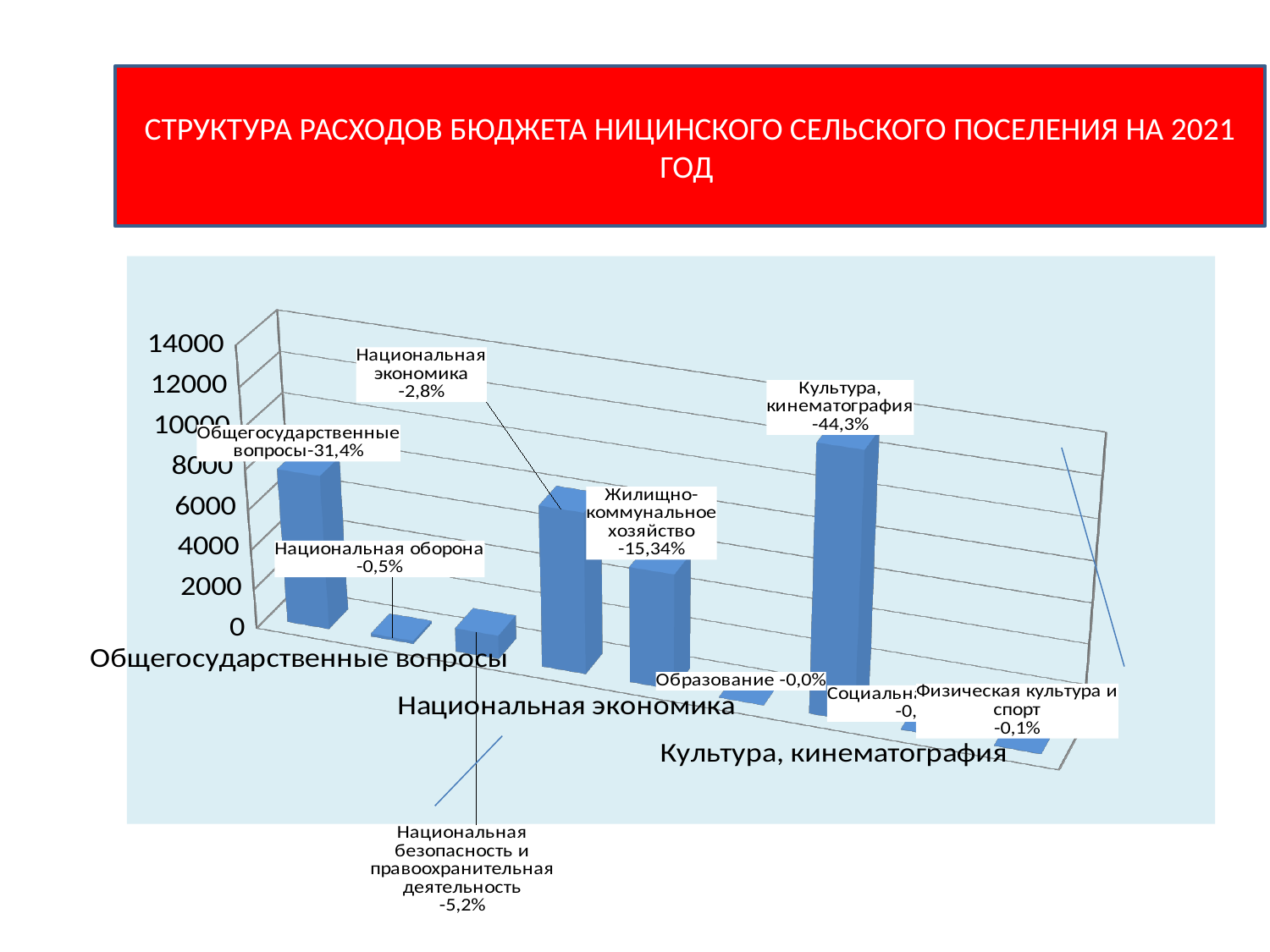
What percentage is shown in the label for Национальная безопасность и правоохранительная деятельность? 5,2% What percentage is shown in the label for Национальная оборона? 0,5% Which bar is taller: Общегосударственные вопросы or Жилищно-коммунальное хозяйство? Общегосударственные вопросы What percentage is shown in the label for Национальная экономика? 2,8% What kind of chart is shown on the slide? bar chart What percentage is shown in the label for Общегосударственные вопросы? 31,4% What percentage is shown in the label for Физическая культура и спорт? 0,1% Is the value for Национальная оборона greater or less than 2000? less What is the difference in percentage points between the labels for Культура, кинематография and Общегосударственные вопросы? 12,9% Which category has the tallest bar in the chart? Культура, кинематография What is the title of the slide above the chart? СТРУКТУРА РАСХОДОВ БЮДЖЕТА НИЦИНСКОГО СЕЛЬСКОГО ПОСЕЛЕНИЯ НА 2021 ГОД What percentage is shown in the label for Жилищно-коммунальное хозяйство? 15,34%